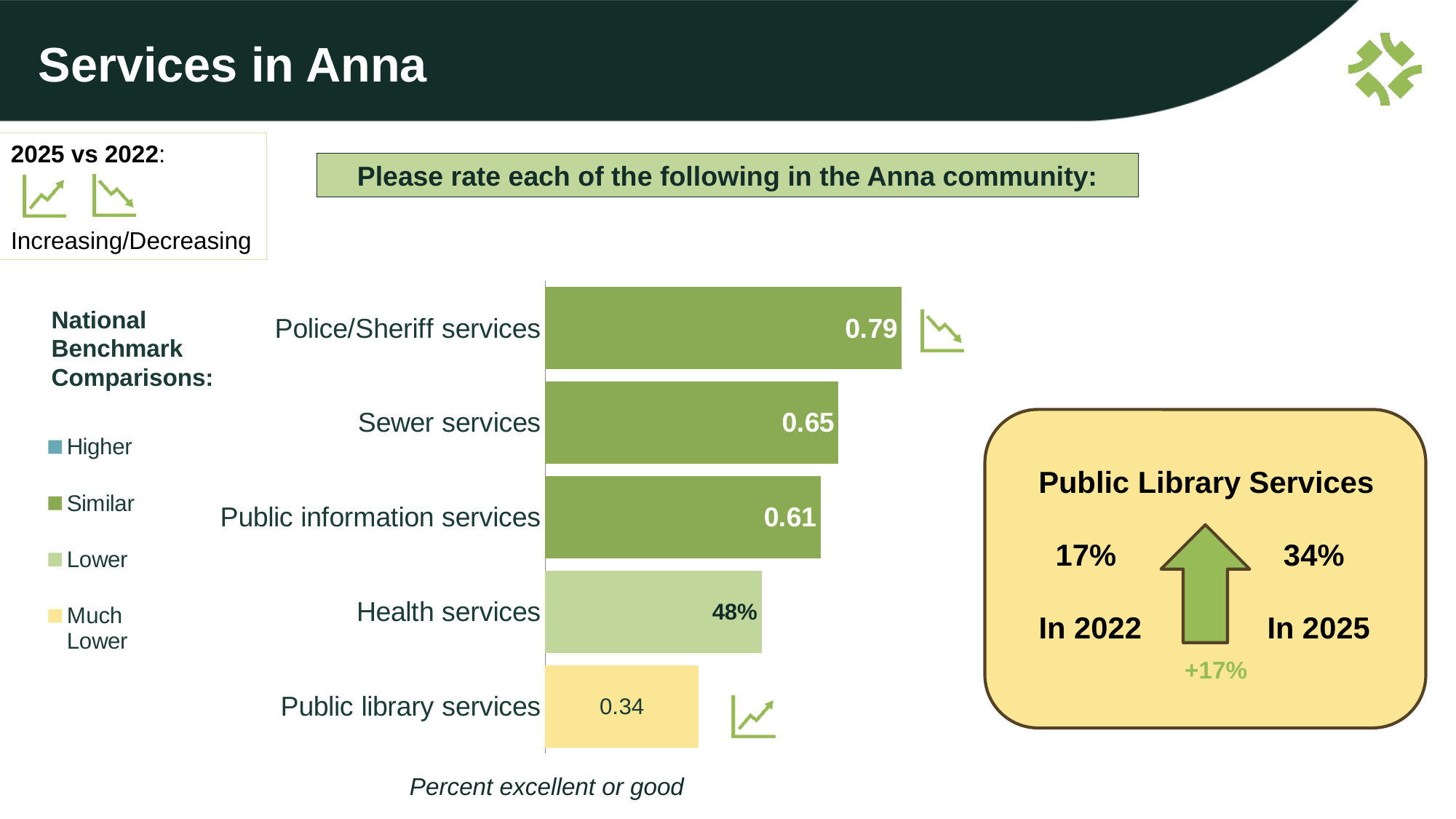
What is the difference between the values for Police/Sheriff services and Sewer services? 0.14 What is the value for Police/Sheriff services? 0.79 What is the value shown for Health services? 48% How many services are plotted in the chart? 5 Which is larger, the value for Sewer services or the value for Public information services? Sewer services Which service has the lowest rating? Public library services What is the value for Public library services? 0.34 How many entries does the National Benchmark Comparisons legend list? 4 What is the value for Public information services? 0.61 What kind of chart is shown on the slide? Bar chart Which service has the highest rating? Police/Sheriff services What is the value for Sewer services? 0.65